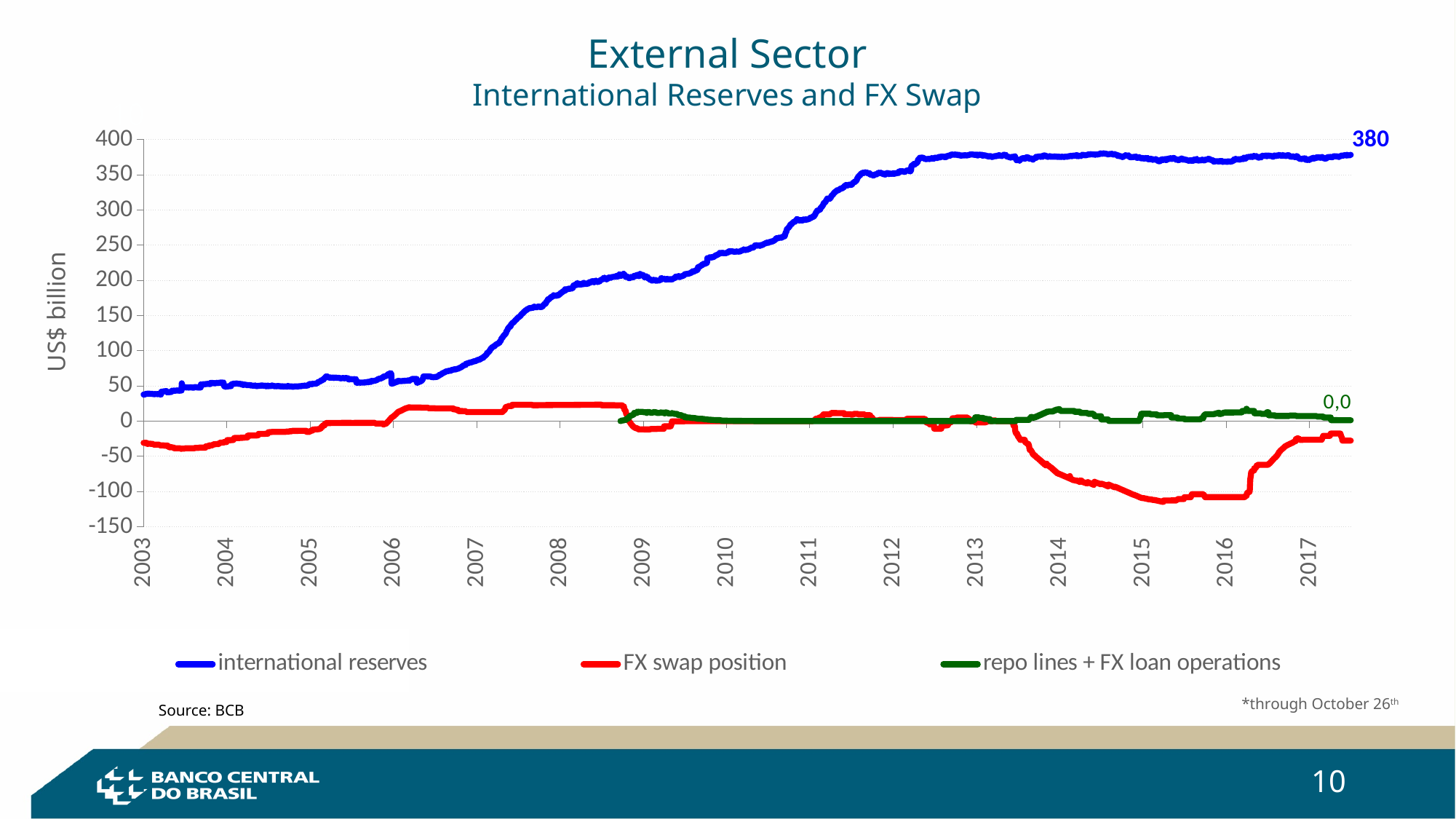
Is the value of international reserves in 2012 greater or less than 300? greater Is the FX swap position in 2015 greater or less than -50? less Is the value of international reserves at the start of 2003 greater or less than 100? less What colour is the line for FX swap position? red How many series does the legend list? 3 At the end of the series in 2017, which is larger: international reserves or FX swap position? international reserves What kind of chart is shown on the slide? line chart What is the latest labelled value of repo lines + FX loan operations? 0,0 What is the label on the vertical axis? US$ billion Do international reserves rise or fall from 2003 to 2017? rise What is the latest labelled value of international reserves? 380